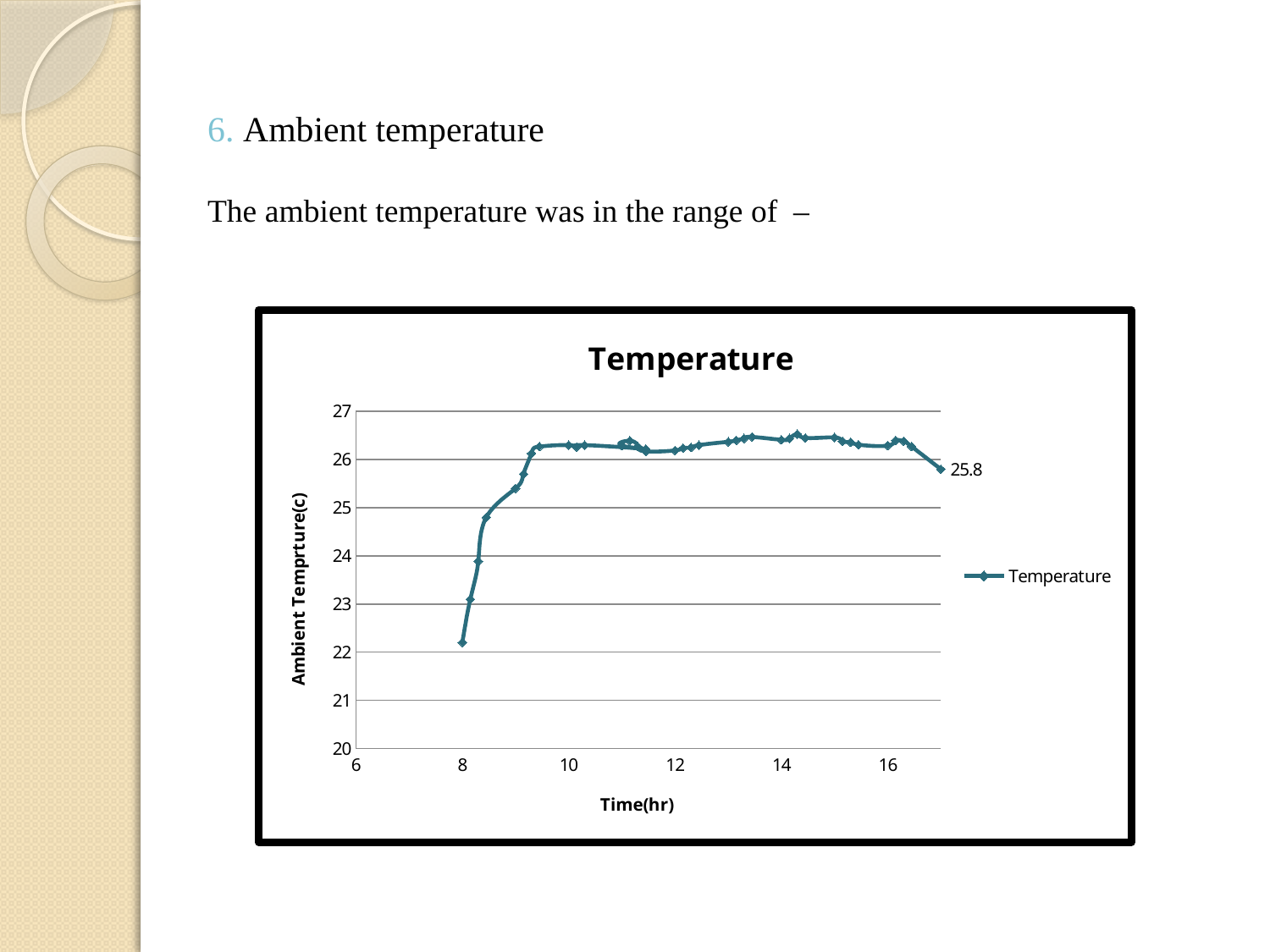
Does the temperature rise or fall between 8 hr and 9.5 hr? rise Is the temperature at 10 hr greater or less than 25? greater What value is printed as the data label on the last point of the Temperature line? 25.8 At what time (hr) is the lowest temperature on the chart recorded? 8 Is the temperature at 12 hr greater or less than the temperature at 8 hr? greater Is the temperature at 14 hr greater or less than 26? greater What is the label on the x axis of the chart? Time(hr) What is the title of the chart? Temperature Is the last plotted temperature value (25.8) greater or less than 26? less What kind of chart is shown on the slide? line chart How many series does the chart's legend list? 1